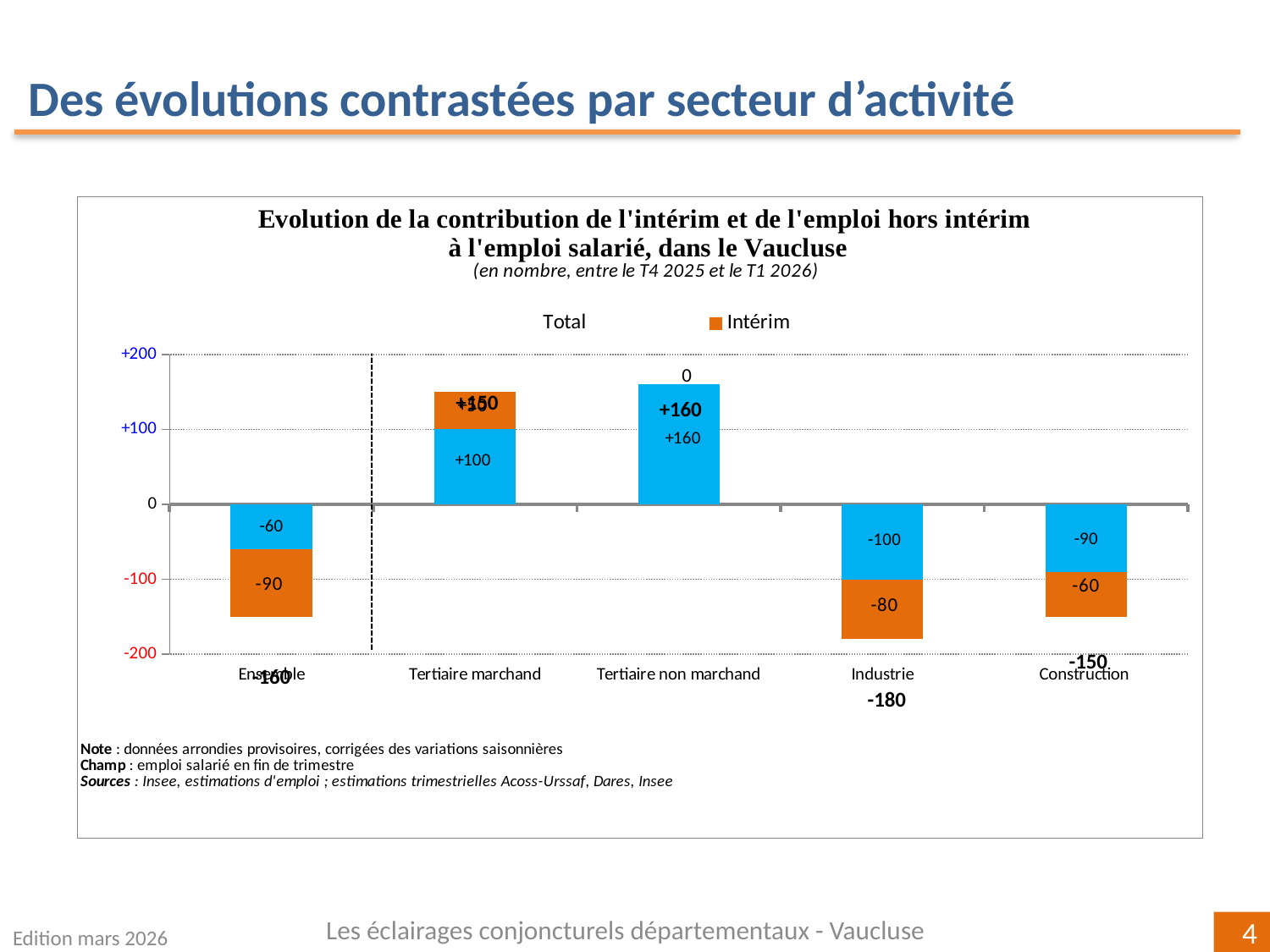
What is the total value shown for Industrie? -180 Which has the more negative Intérim value, Ensemble or Construction? Ensemble What is the Intérim value for Tertiaire non marchand? 0 What is the total value shown for Tertiaire non marchand? +160 What is the Intérim value for Construction? -60 What is the difference between the Intérim values for Industrie and Construction? 20 Which two entries does the chart legend list? Total and Intérim Which sector has the lowest total value? Industrie What is the Intérim value for Industrie? -80 How many sector categories are shown on the x axis of the chart? 5 What is the value of the blue (hors intérim) segment for Tertiaire marchand? +100 What kind of chart is shown on the slide? bar chart